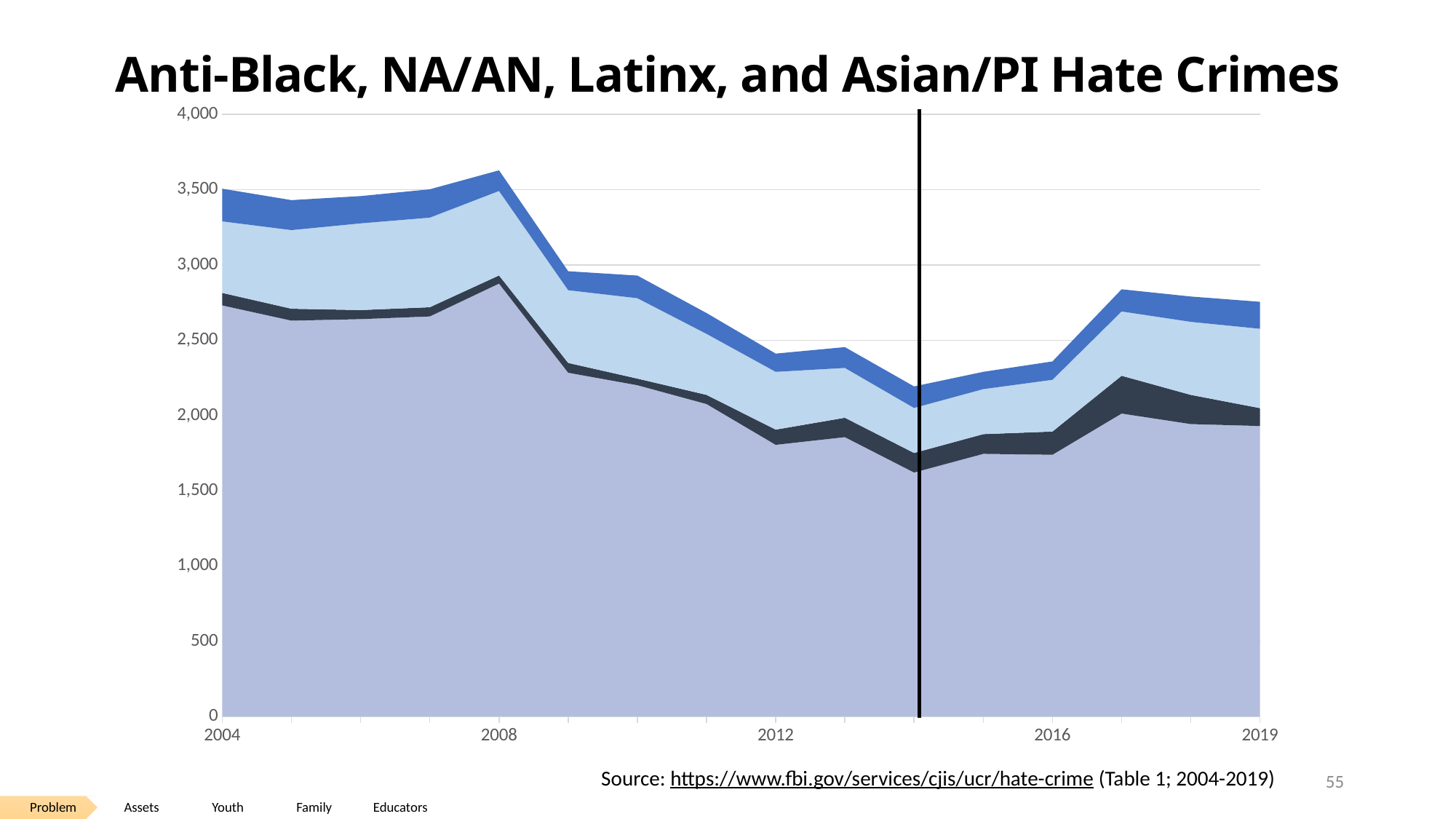
What kind of chart is shown on the slide? Stacked area chart Is the total stacked value for 2016 greater or less than 3,000? less Is the total stacked value for 2014 greater or less than 2,500? less In which year is the total stacked value lowest? 2014 Is the total stacked value for 2008 greater or less than 3,000? greater Does the total stacked value rise or fall from 2008 to 2014? fall What is the title of the chart? Anti-Black, NA/AN, Latinx, and Asian/PI Hate Crimes How many years are plotted along the x axis, from 2004 to 2019? 16 Which year has a larger total stacked value, 2004 or 2012? 2004 Does the total stacked value rise or fall from 2014 to 2017? rise In which year is the total stacked value highest? 2008